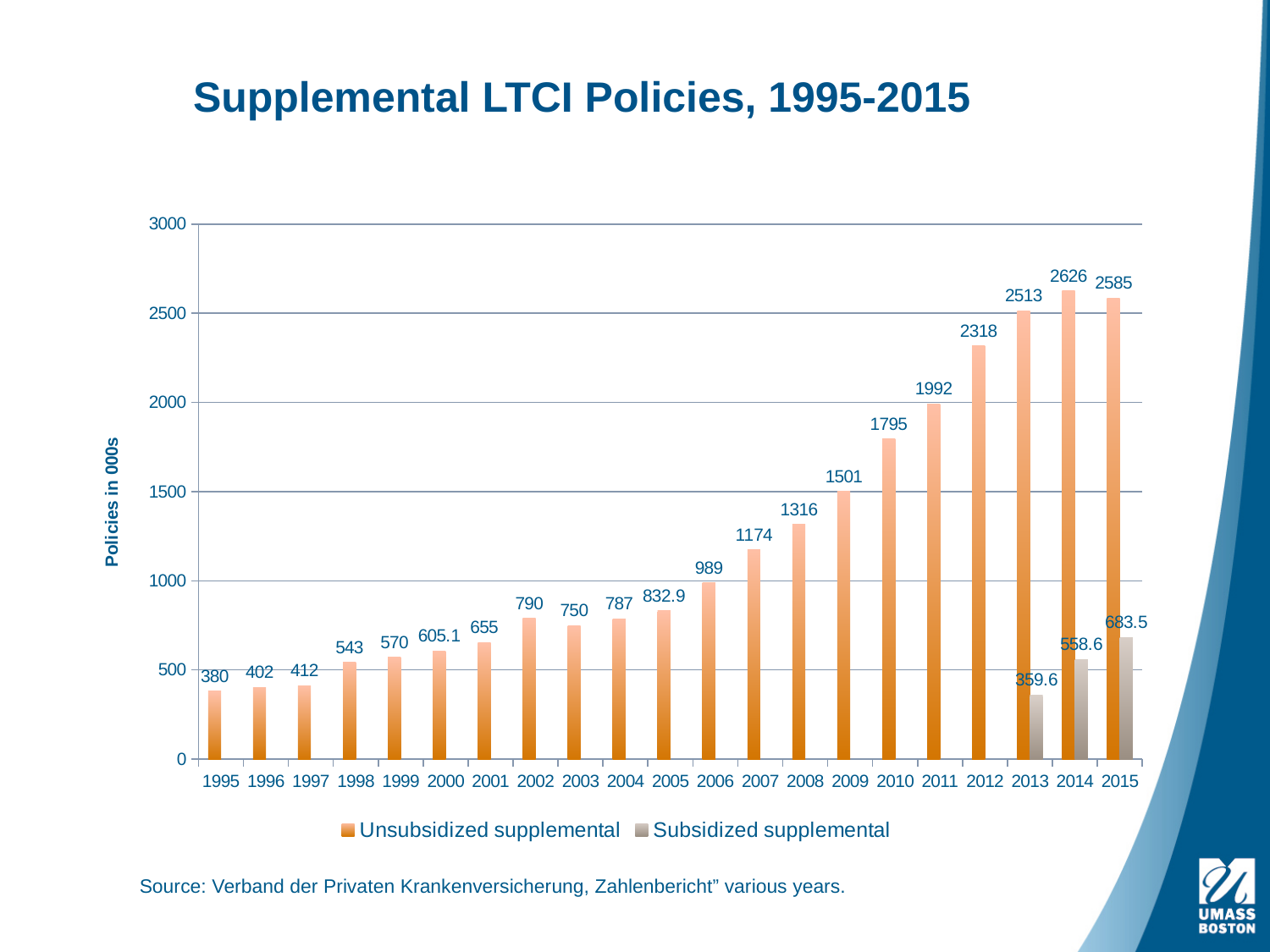
What is the value for Subsidized supplemental in 2013? 359.6 How many years are shown on the x axis? 21 What kind of chart is shown on the slide? bar chart Which year has the highest value for Unsubsidized supplemental? 2014 Is the value for Unsubsidized supplemental in 2009 greater or less than 1500? greater Which is larger, the Unsubsidized supplemental value for 2002 or for 2003? 2002 What is the label of the y axis? Policies in 000s What is the value for Unsubsidized supplemental in 2005? 832.9 How many series does the legend list? 2 Which year has the lowest value for Unsubsidized supplemental? 1995 What is the difference between the Unsubsidized supplemental values for 2014 and 2015? 41 What is the value for Unsubsidized supplemental in 2010? 1795